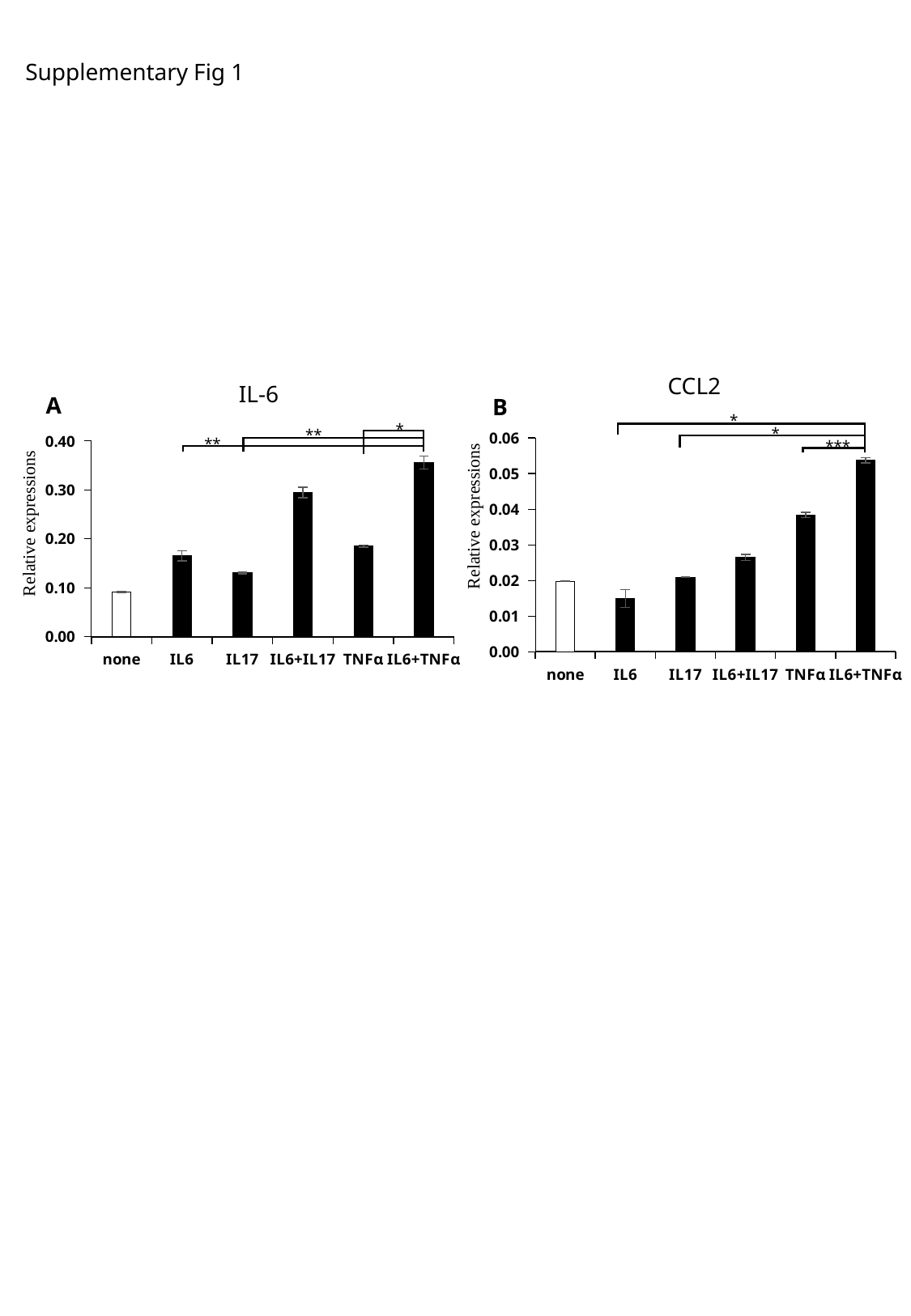
What kind of chart is the IL-6 chart (panel A)? bar chart In the IL-6 chart (panel A), which category has the lowest value? none In the IL-6 chart (panel A), which category has the highest value? IL6+TNFα In the CCL2 chart (panel B), which is larger, the value for TNFα or the value for IL6+IL17? TNFα In the CCL2 chart (panel B), which category has the lowest value? IL6 In the CCL2 chart (panel B), is the value for IL6+TNFα greater or less than 0.05? greater In the IL-6 chart (panel A), which is larger, the value for IL6+IL17 or the value for TNFα? IL6+IL17 In the IL-6 chart (panel A), is the value for IL6+TNFα greater or less than 0.30? greater What is the y-axis title of the CCL2 chart (panel B)? Relative expressions In the CCL2 chart (panel B), which category has the highest value? IL6+TNFα In the IL-6 chart (panel A), how many categories are shown on the x axis? 6 In the IL-6 chart (panel A), is the value for TNFα greater or less than 0.20? less